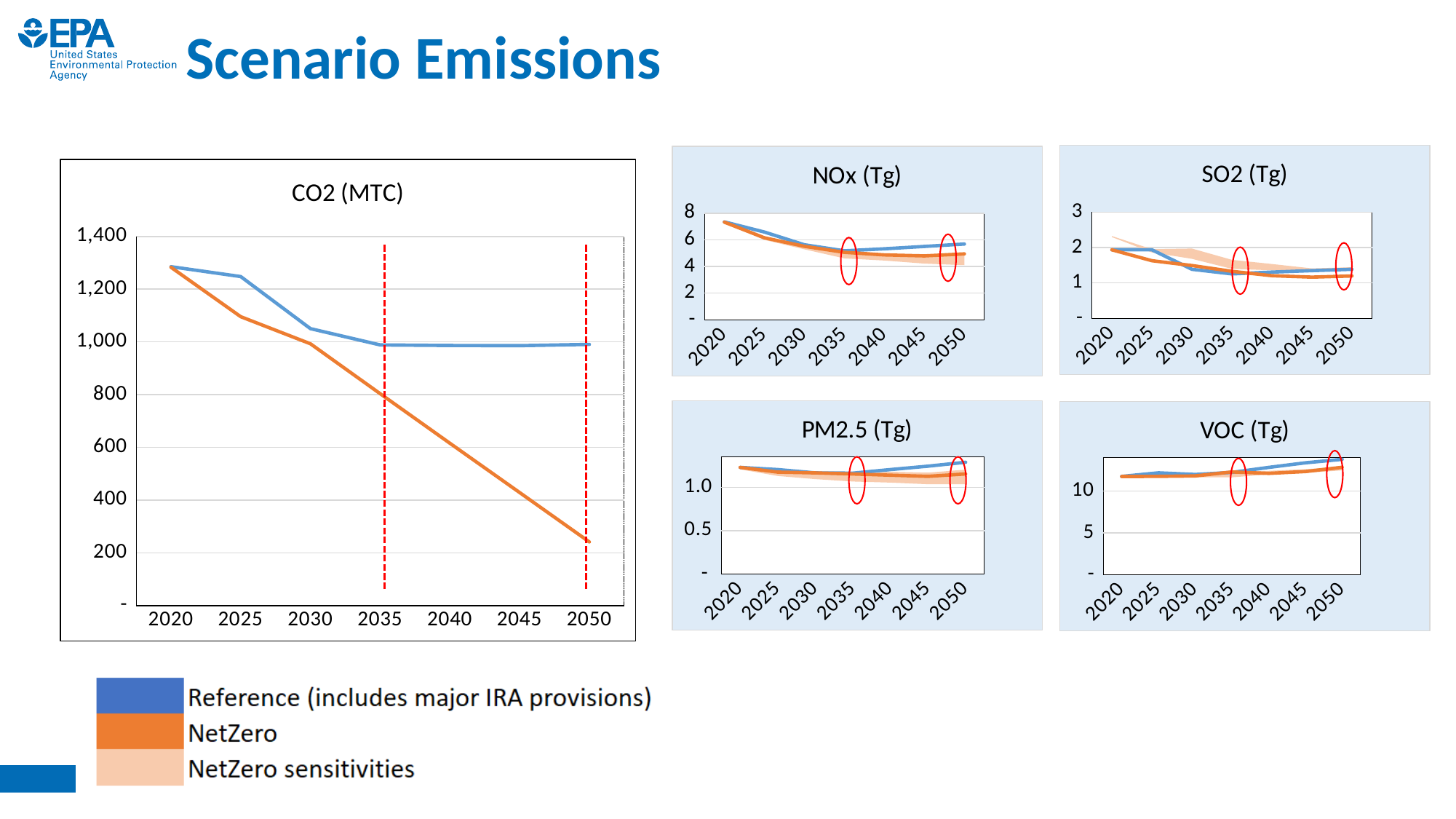
In the CO2 (MTC) chart, is the NetZero value in 2050 greater or less than 400? less In the NOx (Tg) chart, which series has the larger value in 2050, Reference or NetZero? Reference In the VOC (Tg) chart, is the Reference value in 2050 greater or less than 10? greater What kind of chart is the CO2 (MTC) chart? line chart In the CO2 (MTC) chart, does the NetZero line rise or fall from 2020 to 2050? fall In the CO2 (MTC) chart, which series has the larger value in 2050, Reference or NetZero? Reference How many series does the legend at the bottom of the slide list? 3 In the NOx (Tg) chart, is the Reference value in 2020 greater or less than 6? greater In the SO2 (Tg) chart, does the Reference line rise or fall from 2020 to 2050? fall What is the title of the chart in the bottom-right corner of the slide? VOC (Tg) How many year labels are shown on the x axis of the CO2 (MTC) chart? 7